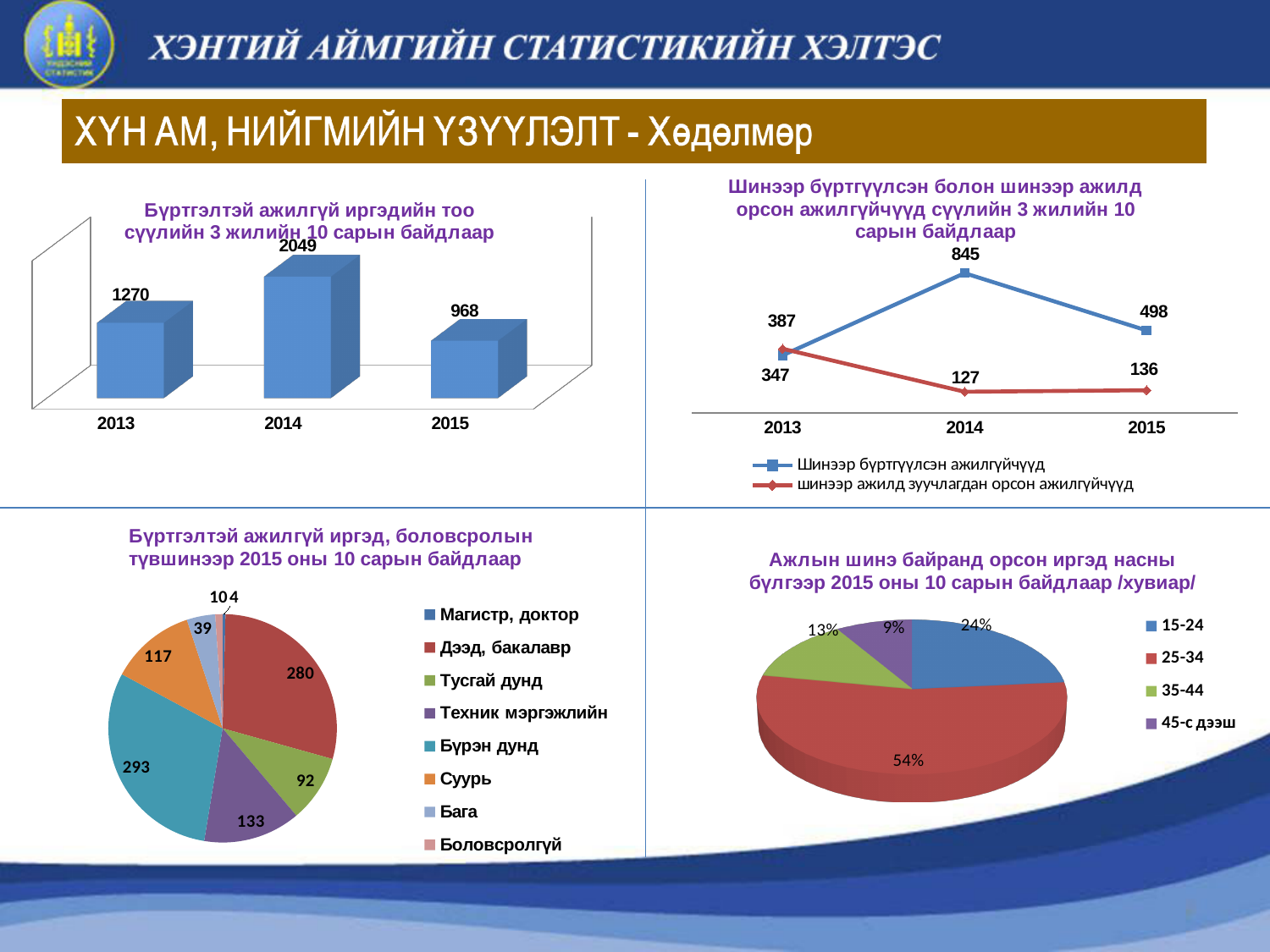
In the top-left bar chart (Бүртгэлтэй ажилгүй иргэдийн тоо), which year has the lowest value? 2015 How many series does the legend of the top-right line chart list? 2 In the bottom-left pie chart (боловсролын түвшинээр), what is the value for Бүрэн дунд? 293 In the top-left bar chart (Бүртгэлтэй ажилгүй иргэдийн тоо), what is the value for 2014? 2049 In the top-left bar chart (Бүртгэлтэй ажилгүй иргэдийн тоо), what is the difference between the 2014 and 2013 values? 779 In the top-right line chart, what is the value of шинээр ажилд зуучлагдан орсон ажилгүйчүүд in 2015? 136 What kind of chart is the top-left chart (Бүртгэлтэй ажилгүй иргэдийн тоо)? Bar chart In the top-right line chart, what is the value of Шинээр бүртгүүлсэн ажилгүйчүүд in 2014? 845 In the bottom-right pie chart (насны бүлгээр), what share does the 25-34 age group have? 54% In the bottom-left pie chart (боловсролын түвшинээр), how many categories does the legend list? 8 In the bottom-right pie chart (насны бүлгээр), which age group has the smallest share? 45-с дээш